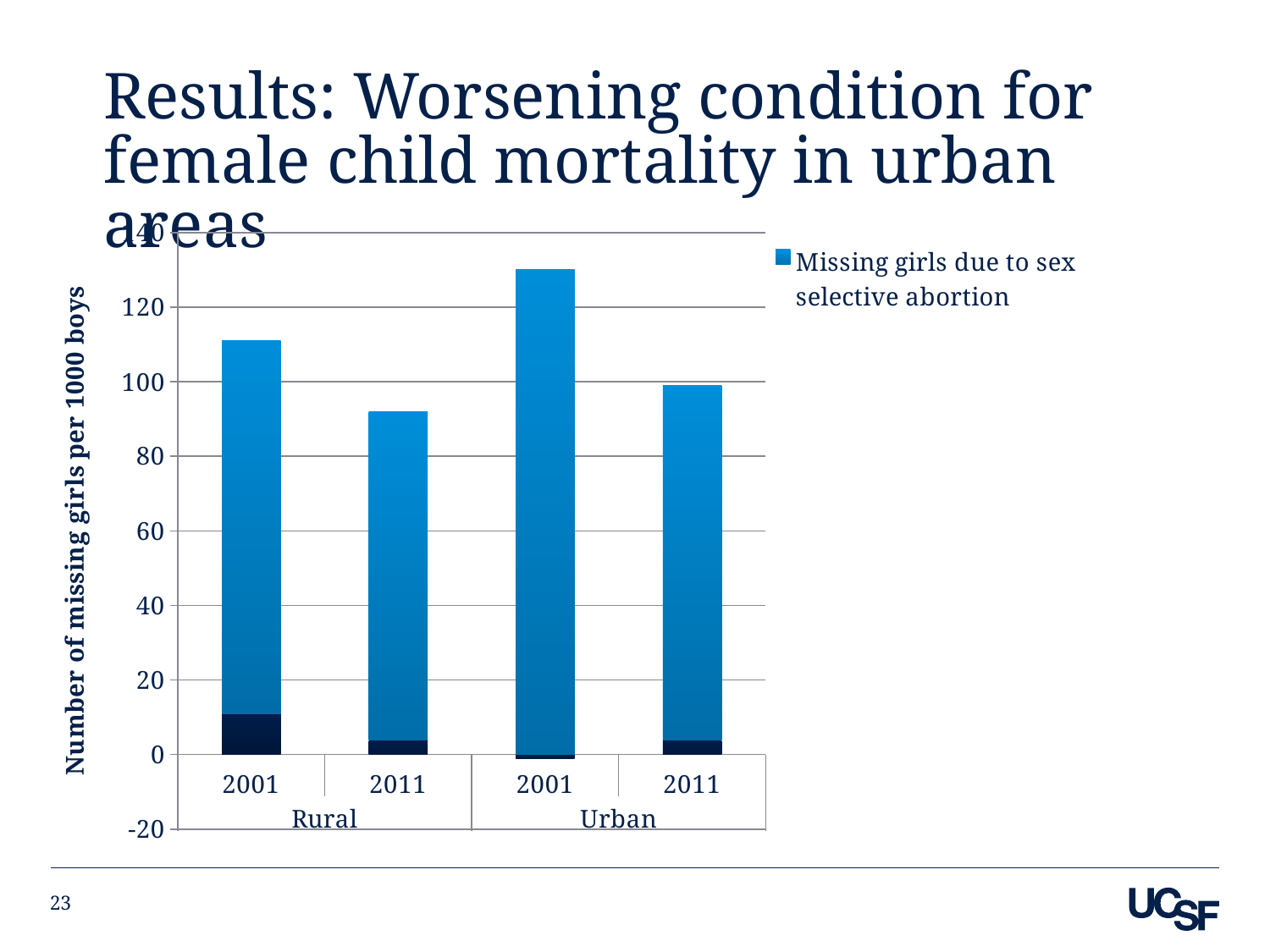
What is the title of the vertical axis? Number of missing girls per 1000 boys Is the top of the Rural 2011 bar greater or less than 100? less How many series does the legend list? 1 Which bar reaches the lowest value in the chart? Rural 2011 Is the top of the Urban 2001 bar greater or less than 120? greater Is the top of the Rural 2001 bar greater or less than 100? greater How many bars are plotted in the chart? 4 Which bar reaches the highest value in the chart? Urban 2001 Within the Urban group, does the bar height rise or fall from 2001 to 2011? Fall What series name is shown in the chart legend? Missing girls due to sex selective abortion Which is taller, the Rural 2001 bar or the Urban 2011 bar? Rural 2001 What kind of chart is shown on the slide? Bar chart